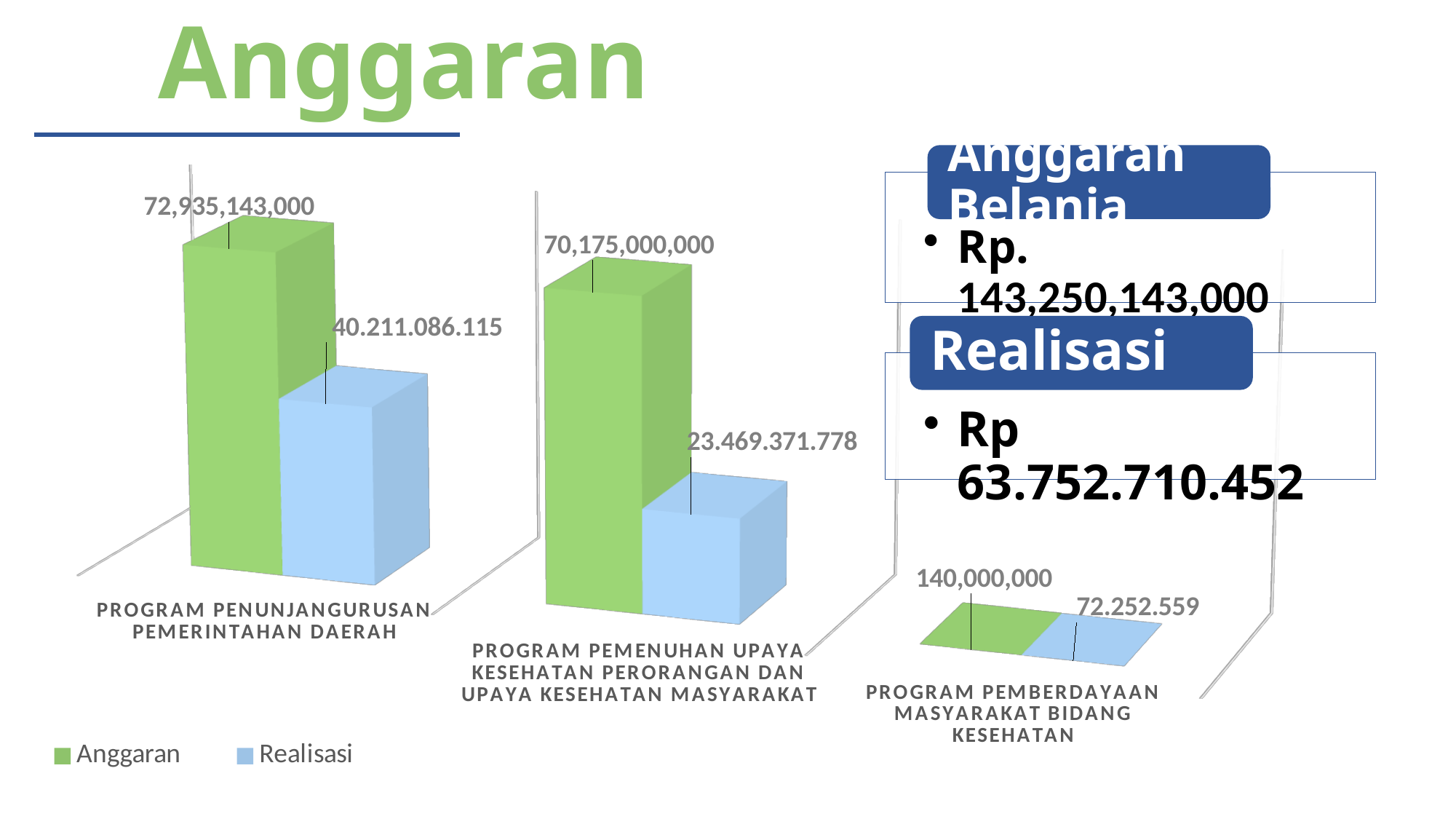
What is the Anggaran value for Program Pemenuhan Upaya Kesehatan Perorangan dan Upaya Kesehatan Masyarakat? 70,175,000,000 What is the Realisasi value for Program Penunjangurusan Pemerintahan Daerah? 40.211.086.115 What is the Anggaran value for Program Penunjangurusan Pemerintahan Daerah? 72,935,143,000 What is the Anggaran value for Program Pemberdayaan Masyarakat Bidang Kesehatan? 140,000,000 Which is larger for Program Pemenuhan Upaya Kesehatan Perorangan dan Upaya Kesehatan Masyarakat: Anggaran or Realisasi? Anggaran Which program has the lowest Realisasi value? Program Pemberdayaan Masyarakat Bidang Kesehatan Which program has the highest Anggaran value? Program Penunjangurusan Pemerintahan Daerah What is the difference between the Anggaran values for Program Penunjangurusan Pemerintahan Daerah and Program Pemenuhan Upaya Kesehatan Perorangan dan Upaya Kesehatan Masyarakat? 2,760,143,000 What is the Realisasi value for Program Pemenuhan Upaya Kesehatan Perorangan dan Upaya Kesehatan Masyarakat? 23.469.371.778 How many programs (categories) are shown in the chart? 3 What is the Realisasi value for Program Pemberdayaan Masyarakat Bidang Kesehatan? 72.252.559 How many series does the chart legend list? 2